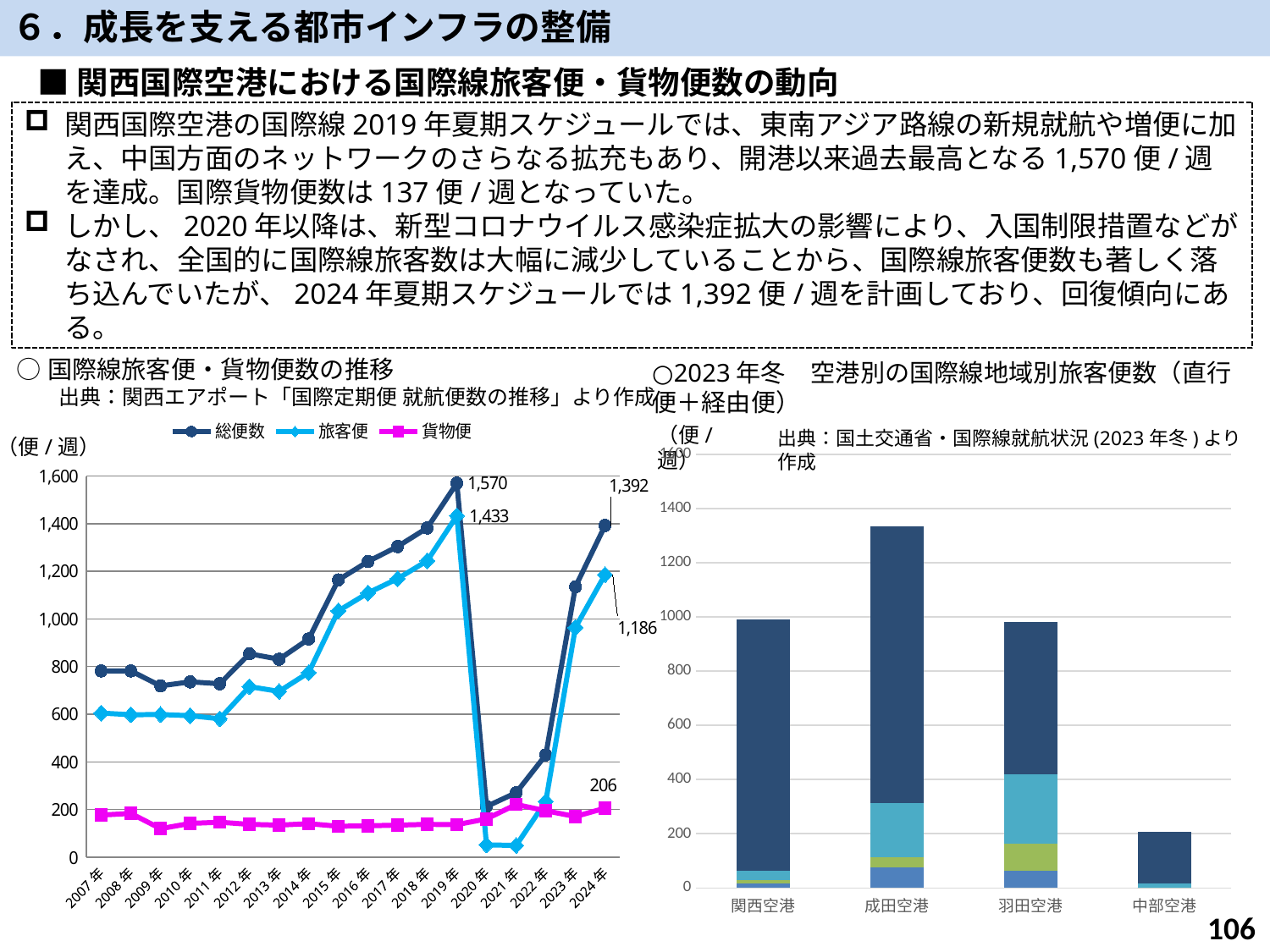
In the left chart (国際線旅客便・貨物便数の推移), what is the value of 貨物便 in 2024年? 206 In the left chart (国際線旅客便・貨物便数の推移), what is the value of 総便数 in 2019年? 1,570 In the left chart (国際線旅客便・貨物便数の推移), how many years are shown on the x axis? 18 What kind of chart is the left chart, 国際線旅客便・貨物便数の推移? line chart In the left chart (国際線旅客便・貨物便数の推移), what is the difference between 総便数 in 2019年 and 総便数 in 2024年? 178 In the right chart (2023年冬 空港別の国際線地域別旅客便数), which airport has the lowest total? 中部空港 How many series does the legend of the left chart (国際線旅客便・貨物便数の推移) list? 3 In the left chart (国際線旅客便・貨物便数の推移), what is the value of 総便数 in 2024年? 1,392 In the right chart (2023年冬 空港別の国際線地域別旅客便数), is the total for 成田空港 greater or less than 1200? greater In the left chart (国際線旅客便・貨物便数の推移), what is the value of 旅客便 in 2019年? 1,433 In the right chart (2023年冬 空港別の国際線地域別旅客便数), which airport has the highest total? 成田空港 What kind of chart is the right chart, 2023年冬 空港別の国際線地域別旅客便数? bar chart